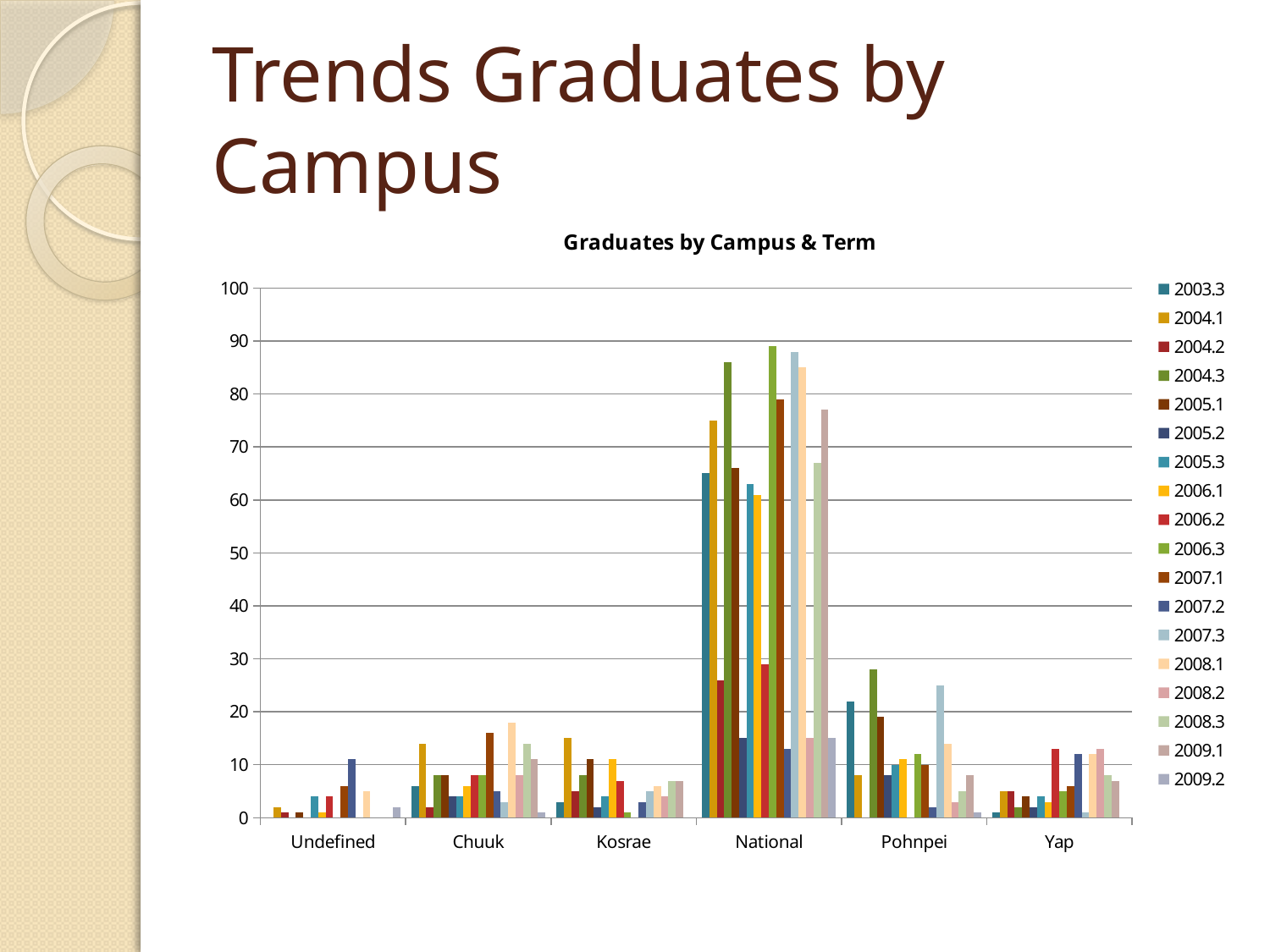
Is the value for Pohnpei in 2007.3 greater or less than 20? greater How many campus categories are shown along the x axis? 6 What is the title of the chart? Graduates by Campus & Term Is the value for Chuuk in 2008.1 greater or less than 20? less Is the value for National in 2004.2 greater or less than 30? less What type of chart is shown on the slide? bar chart Which campus category has the highest bars overall? National Which is larger for 2004.3: the value for Pohnpei or the value for Yap? Pohnpei Which is larger for 2003.3: the value for National or the value for Pohnpei? National How many series does the legend list? 18